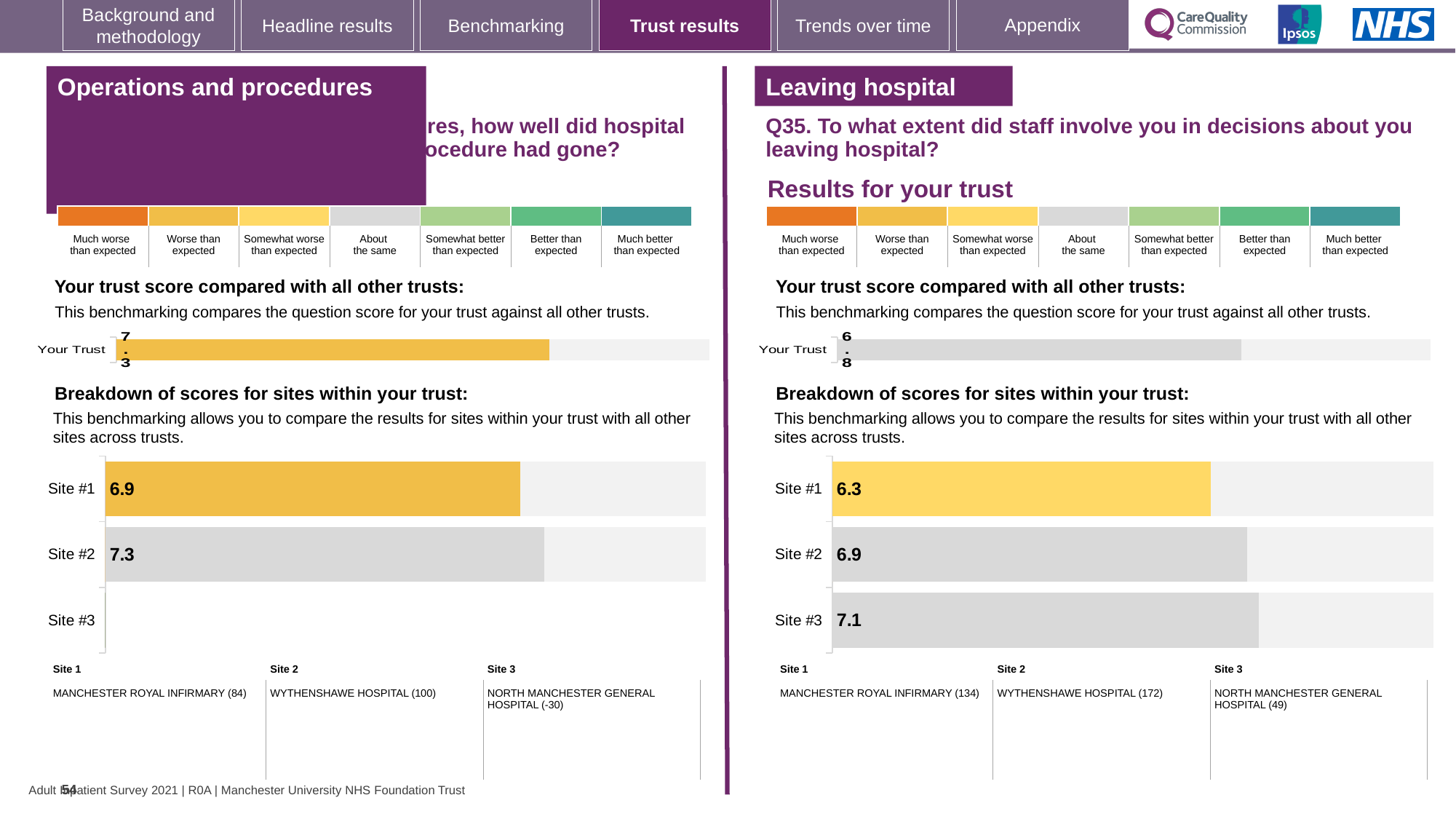
On the Leaving hospital site breakdown chart, what is the score for Site #1? 6.3 What type of chart is used for the site breakdown on the Leaving hospital side? Bar chart On the Leaving hospital site breakdown chart, which site has the lowest score? Site #1 How many site categories are listed on the Leaving hospital site breakdown chart? 3 On the Leaving hospital 'Your trust score compared with all other trusts' chart, what is the score for Your Trust? 6.8 On the Leaving hospital site breakdown chart, which site has the highest score? Site #3 On the Operations and procedures 'Your trust score compared with all other trusts' chart, what is the score for Your Trust? 7.3 On the Leaving hospital site breakdown chart, what is the difference between the scores for Site #3 and Site #1? 0.8 On the Operations and procedures site breakdown chart, which is larger, the score for Site #1 or Site #2? Site #2 On the Leaving hospital site breakdown chart, what is the score for Site #3? 7.1 On the Operations and procedures site breakdown chart, what is the score for Site #2? 7.3 On the Operations and procedures site breakdown chart, what is the score for Site #1? 6.9